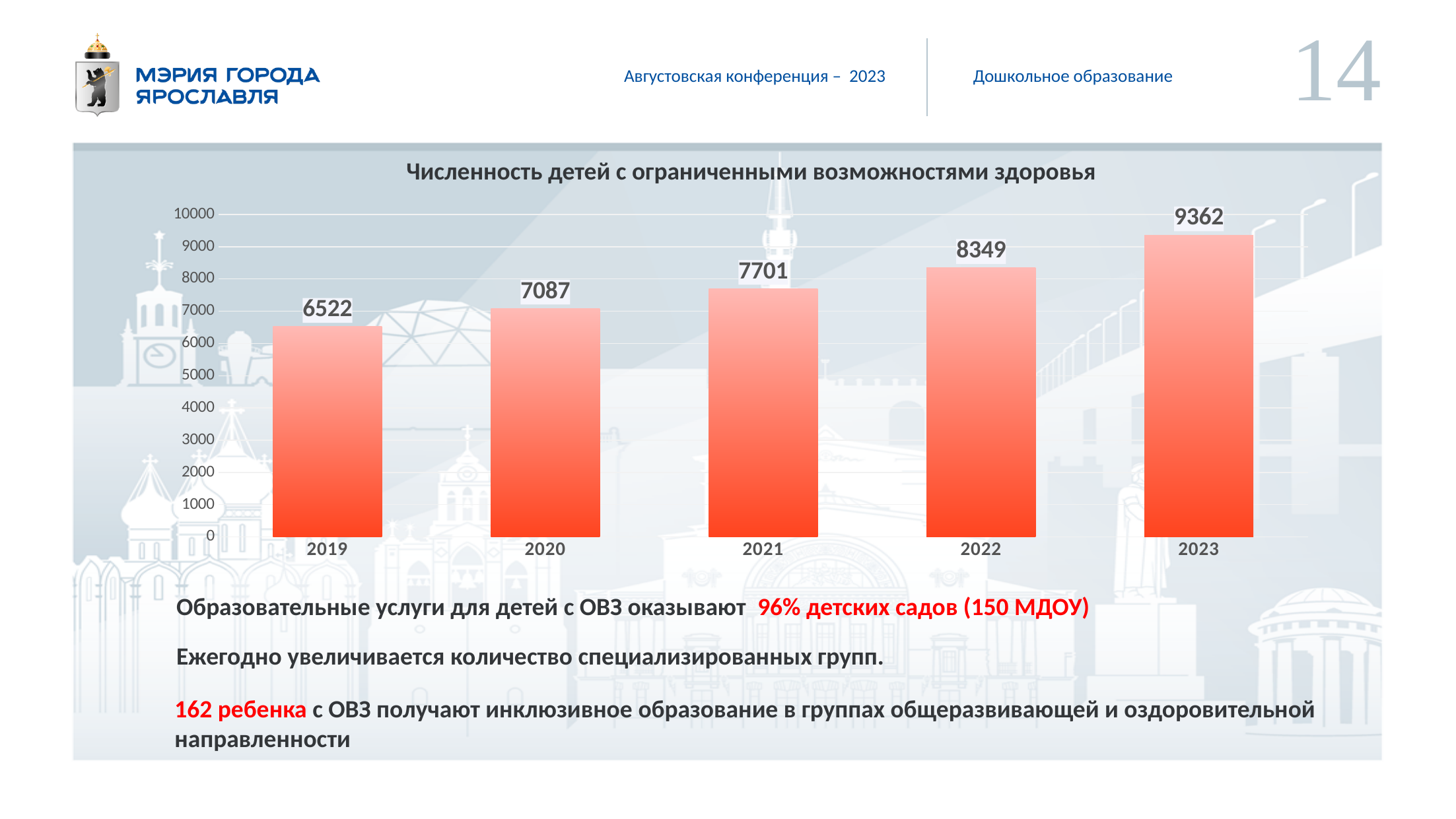
Do the values rise or fall from 2019 to 2023? rise What is the difference between the values for 2020 and 2019? 565 Which year has the highest value? 2023 Which is larger, the value for 2021 or the value for 2020? 2021 What is the difference between the values for 2023 and 2022? 1013 Is the value for 2022 greater or less than 8000? greater What is the value for 2023? 9362 Which year has the lowest value? 2019 What is the value for 2019? 6522 What is the value for 2021? 7701 How many years are shown on the x axis? 5 What kind of chart is shown on the slide? bar chart